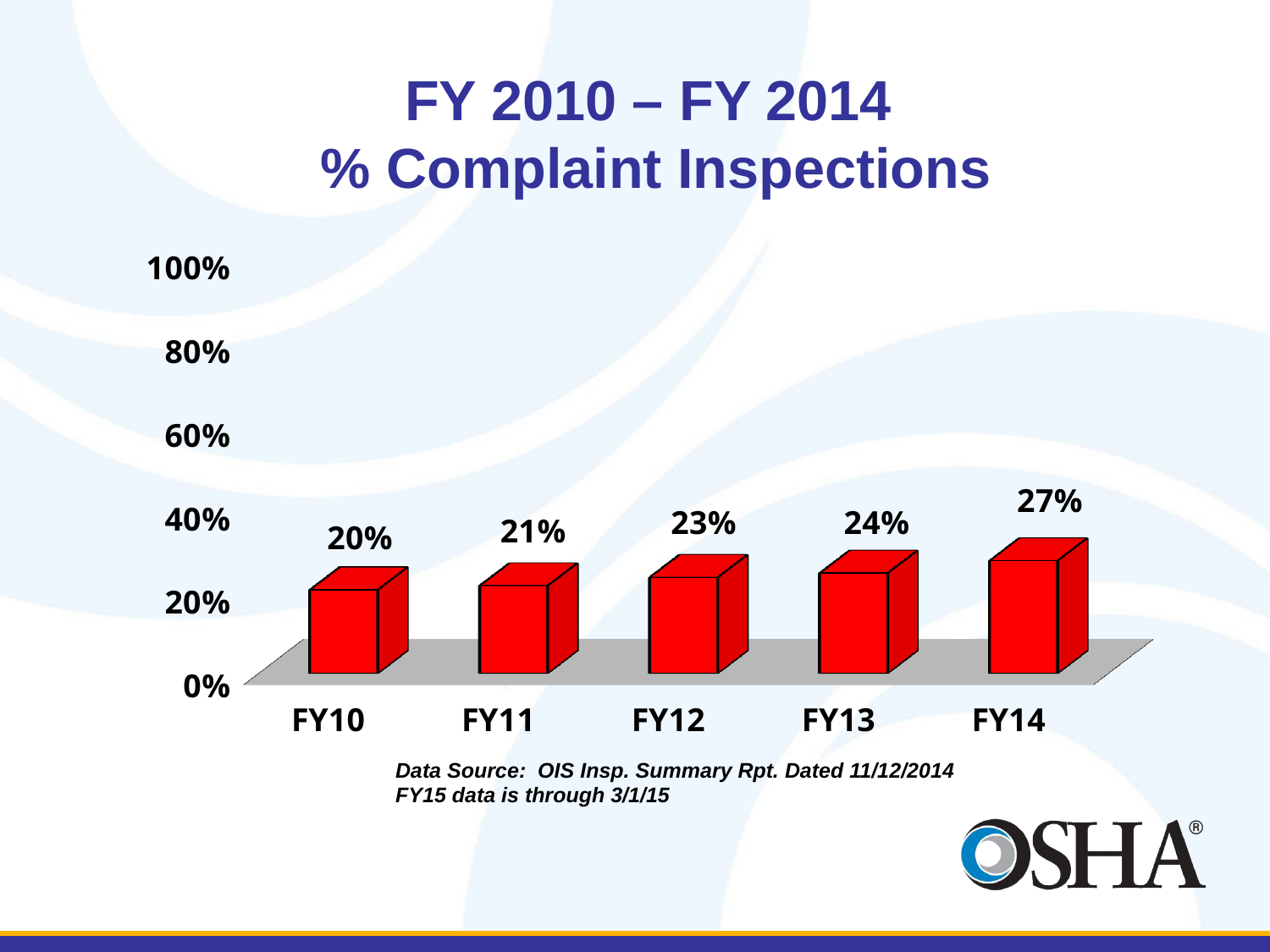
What is the value for FY10? 20% Which is larger, the value for FY12 or the value for FY13? FY13 Which fiscal year has the lowest percentage of complaint inspections? FY10 Is the value for FY14 greater or less than 40%? less What is the difference between the values for FY14 and FY10? 7% What is the value for FY12? 23% Do the values rise or fall from FY10 to FY14? rise What kind of chart is shown on the slide? bar chart What is the value for FY14? 27% How many fiscal years are shown on the x axis? 5 What is the difference between the values for FY13 and FY11? 3% Which fiscal year has the highest percentage of complaint inspections? FY14